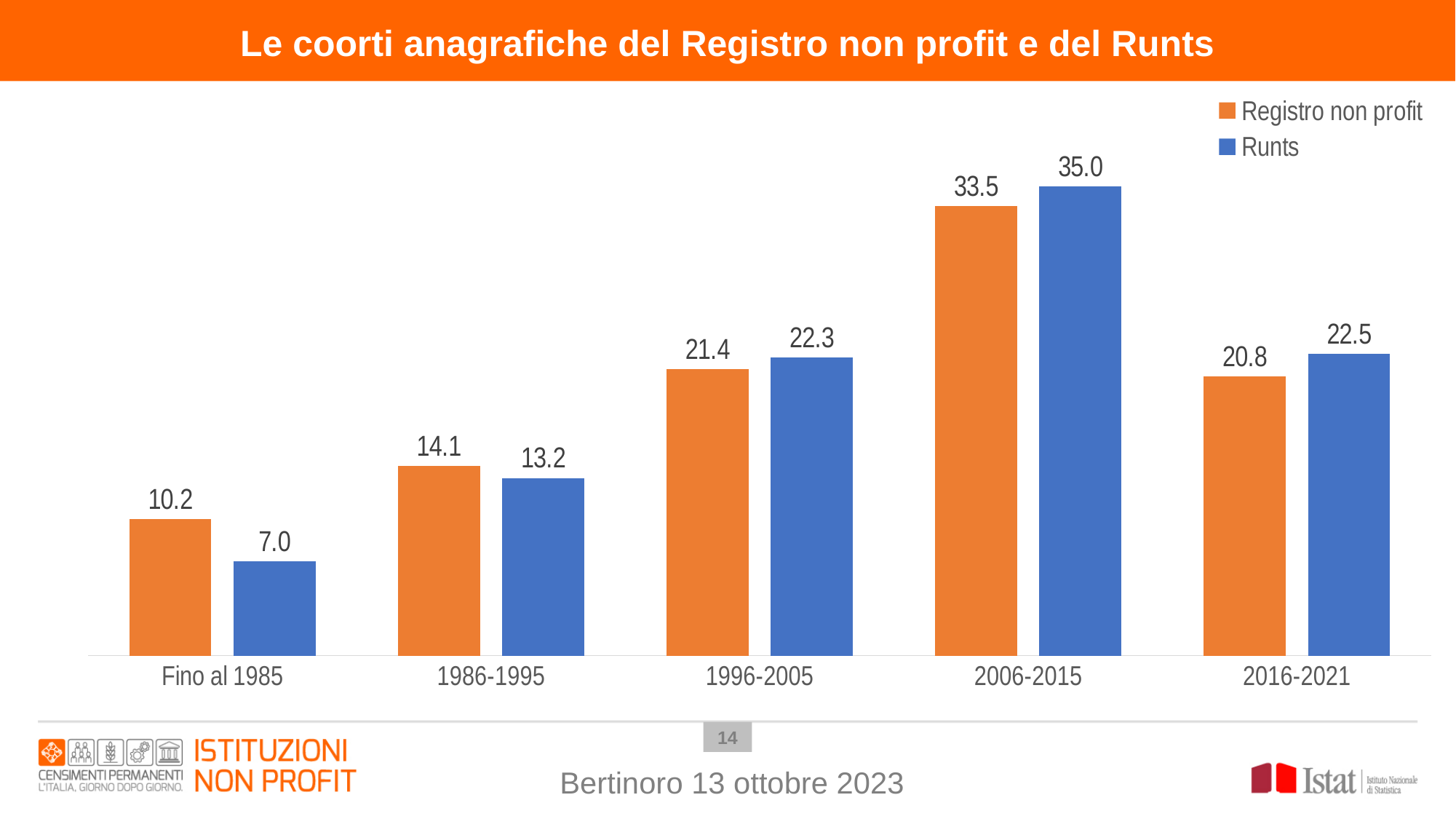
What kind of chart is shown on the slide? Bar chart What is the difference between Registro non profit and Runts in the Fino al 1985 cohort? 3.2 What is the value for Registro non profit in the 2006-2015 cohort? 33.5 Which cohort has the highest value for Runts? 2006-2015 Which cohort has the lowest value for Registro non profit? Fino al 1985 What is the value for Runts in the 2016-2021 cohort? 22.5 In the 1986-1995 cohort, which series has the larger value, Registro non profit or Runts? Registro non profit How many series does the legend list? 2 What is the value for Runts in the Fino al 1985 cohort? 7.0 Which colour represents the Runts series? Blue How many cohorts are shown on the x axis? 5 What is the difference between Runts and Registro non profit in the 2006-2015 cohort? 1.5